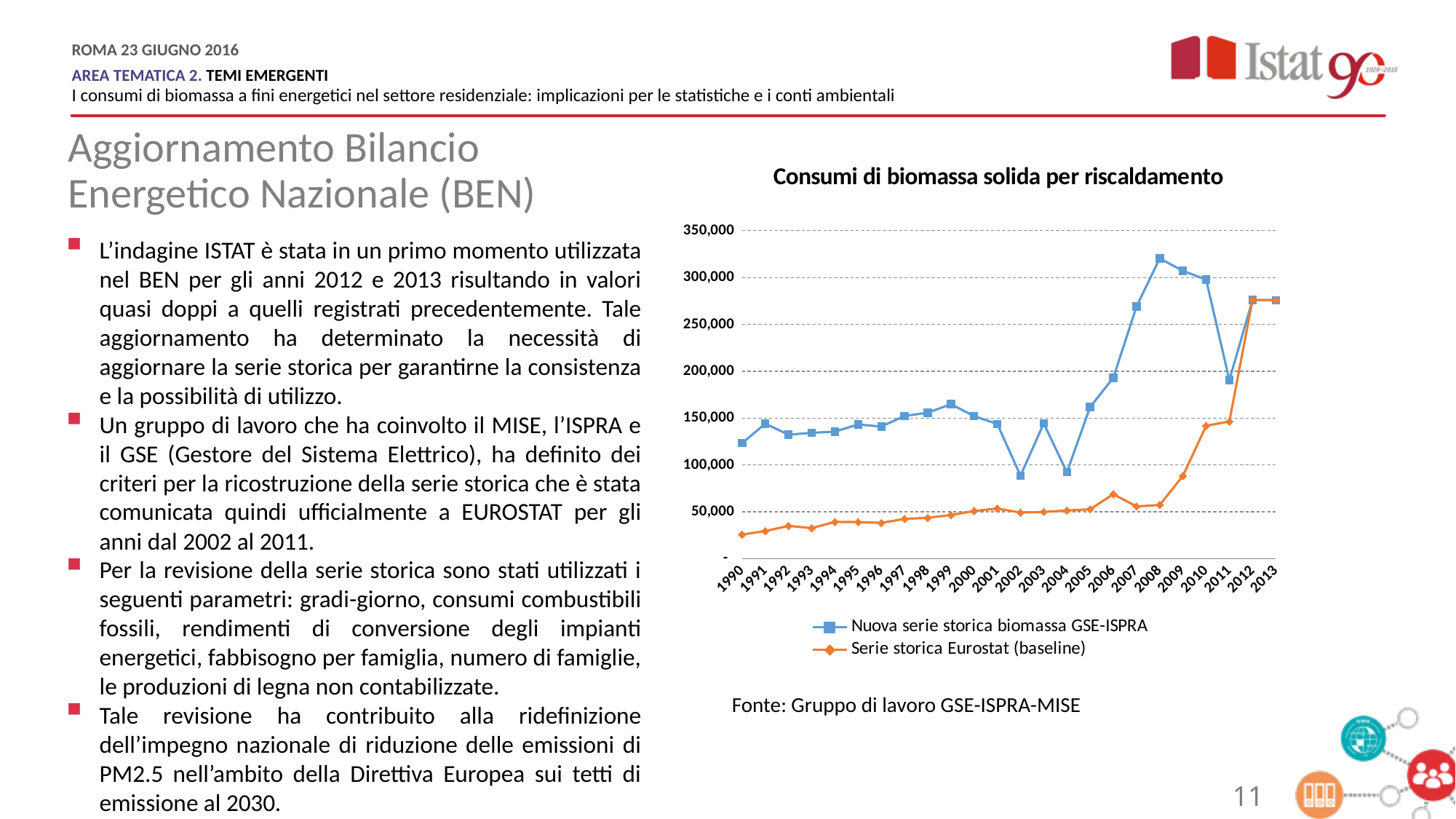
Is the value of the 'Nuova serie storica biomassa GSE-ISPRA' series in 2008 greater or less than 300,000? greater Which series is drawn in orange in the chart? Serie storica Eurostat (baseline) In 2008, which series has the larger value: 'Nuova serie storica biomassa GSE-ISPRA' or 'Serie storica Eurostat (baseline)'? Nuova serie storica biomassa GSE-ISPRA How many years are plotted along the x axis of the chart? 24 Is the value of the 'Nuova serie storica biomassa GSE-ISPRA' series in 2002 greater or less than 100,000? less How many series does the chart legend list? 2 Does the 'Serie storica Eurostat (baseline)' series generally rise or fall from 1990 to 2013? rise Is the value of the 'Serie storica Eurostat (baseline)' series in 2013 greater or less than 250,000? greater In which year does the 'Nuova serie storica biomassa GSE-ISPRA' series reach its highest value? 2008 What is the title of the chart? Consumi di biomassa solida per riscaldamento What kind of chart is shown on the slide? line chart